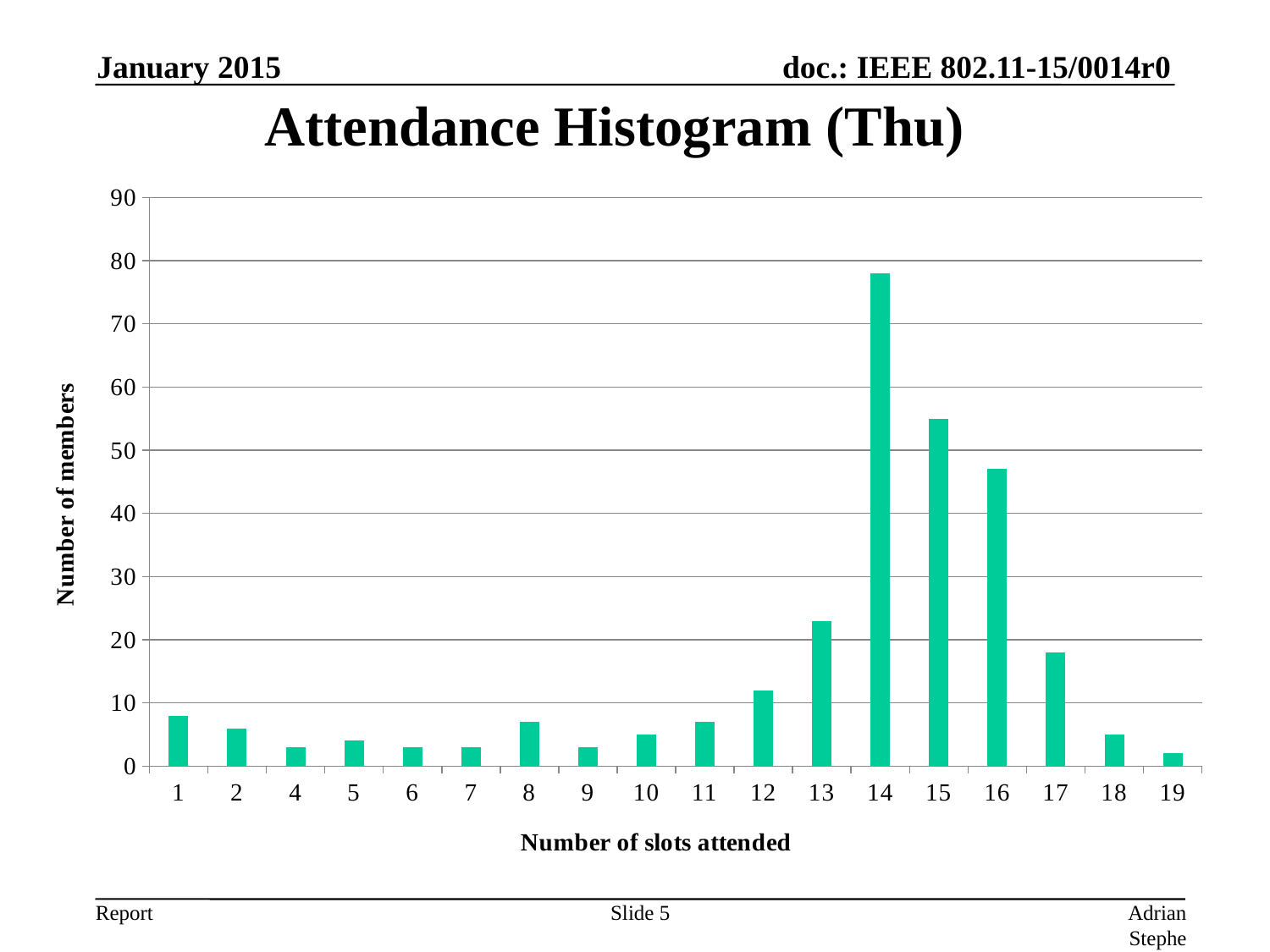
Is the number of members for 15 slots attended greater or less than 50? greater Which has more members: 14 slots attended or 15 slots attended? 14 Is the number of members for 1 slot attended greater or less than 10? less What is the label of the y axis of the chart? Number of members Is the number of members for 16 slots attended greater or less than 50? less What kind of chart is shown on the slide? bar chart How many categories are shown on the x axis of the chart? 18 Which number of slots attended has the highest number of members? 14 Which has more members: 13 slots attended or 17 slots attended? 13